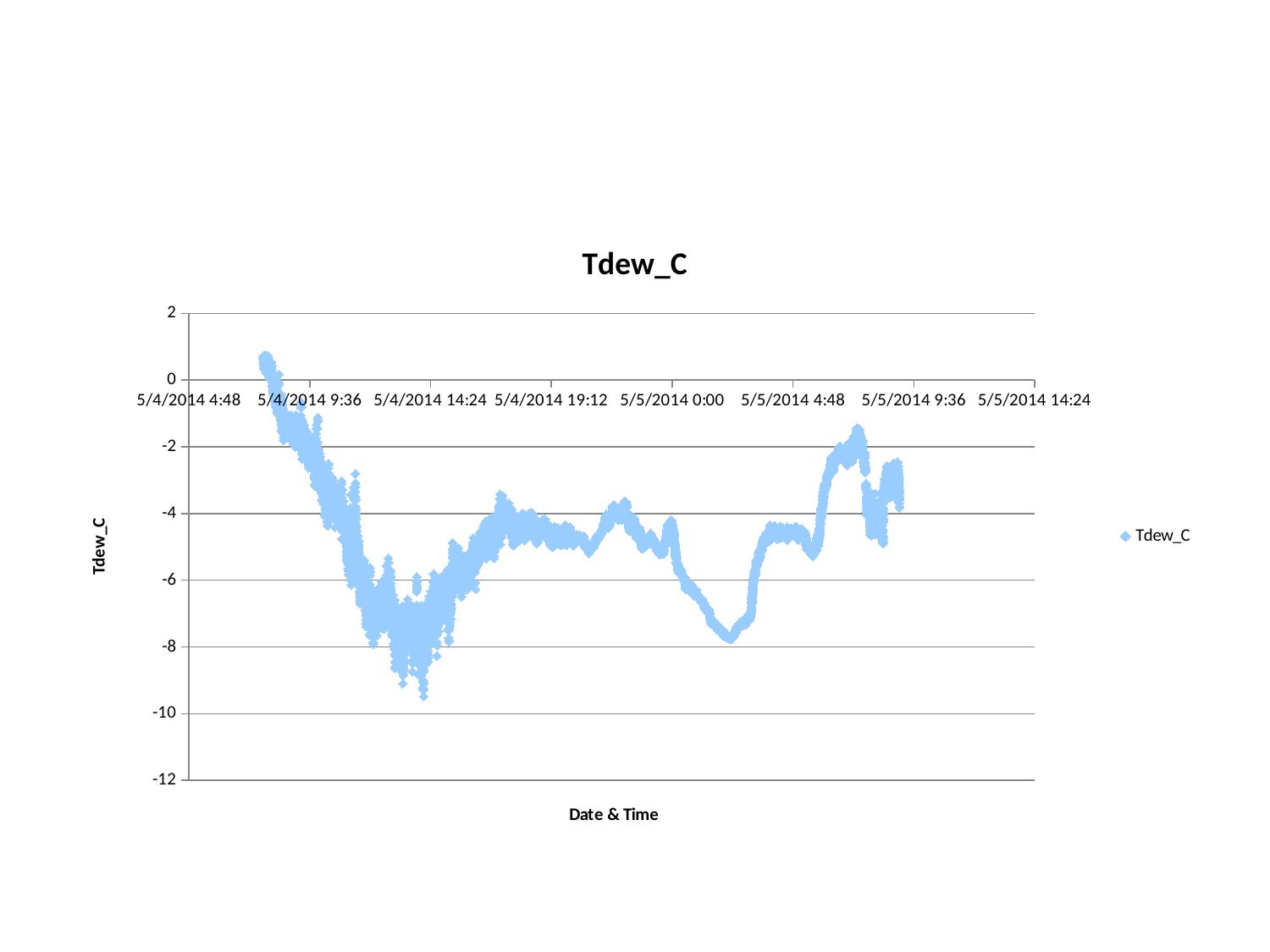
What is the label on the x axis of the chart? Date & Time Is the value for Tdew_C at 5/5/2014 4:48 greater or less than -6? greater Is the highest Tdew_C value plotted greater or less than 0? greater Do the Tdew_C values rise or fall between 5/4/2014 14:24 and 5/4/2014 19:12? rise Do the Tdew_C values rise or fall between 5/4/2014 9:36 and 5/4/2014 14:24? fall Is the value for Tdew_C at 5/4/2014 9:36 greater or less than -4? greater How many series does the legend list? 1 What is the title of the chart? Tdew_C What kind of chart is shown on the slide? scatter chart